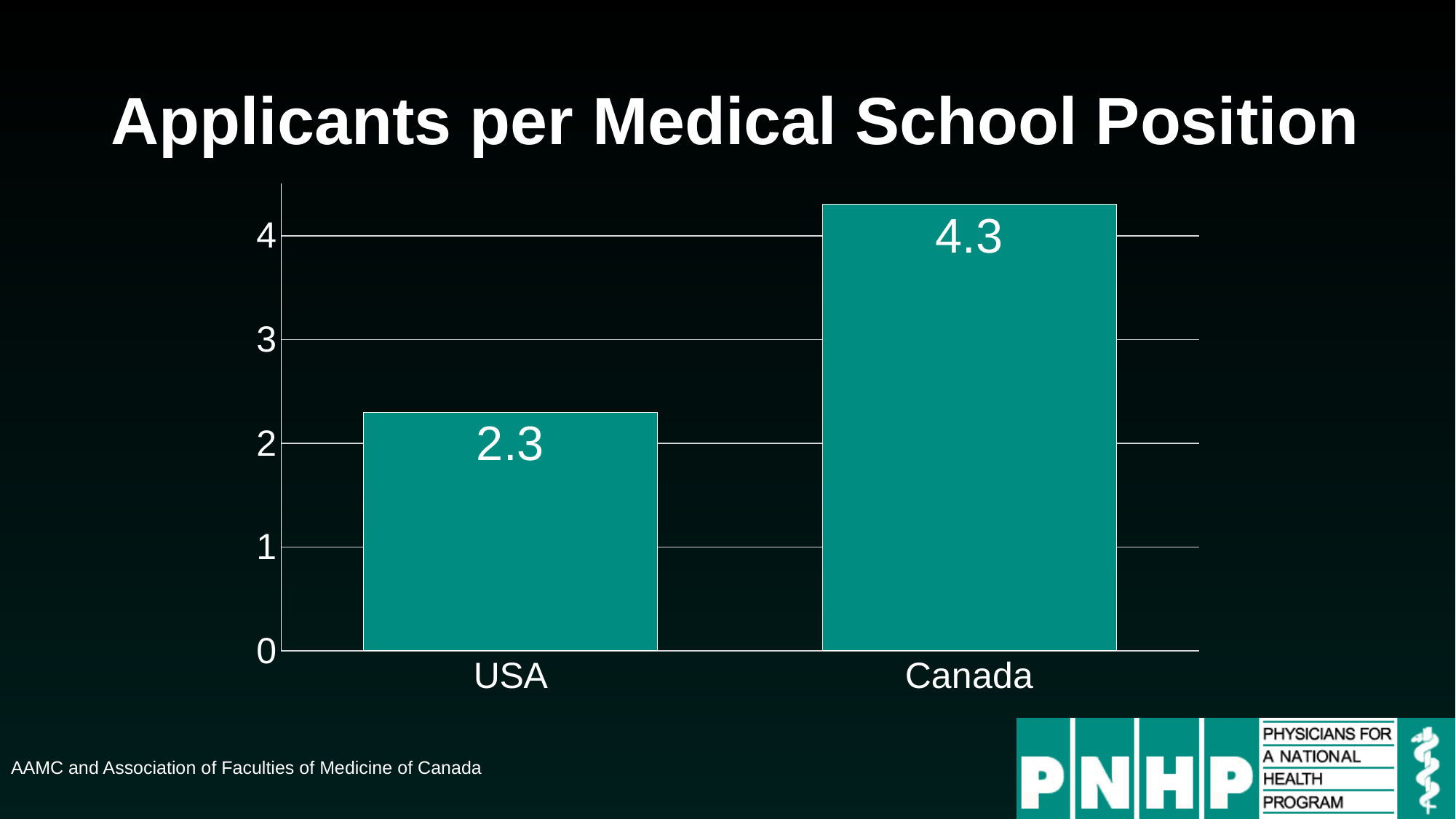
Is the value for the USA larger or smaller than the value for Canada? smaller Is the value for the USA greater or less than 3? less What is the title of the chart? Applicants per Medical School Position What kind of chart is shown on the slide? bar chart What is the number of applicants per medical school position for the USA? 2.3 Is the value for Canada greater or less than 4? greater Which country has the higher number of applicants per medical school position? Canada Which country has the lower number of applicants per medical school position? USA What is the difference between Canada's and the USA's applicants per medical school position? 2.0 How many countries are shown in the chart? 2 What is the highest value labelled on the vertical axis? 4 What is the number of applicants per medical school position for Canada? 4.3